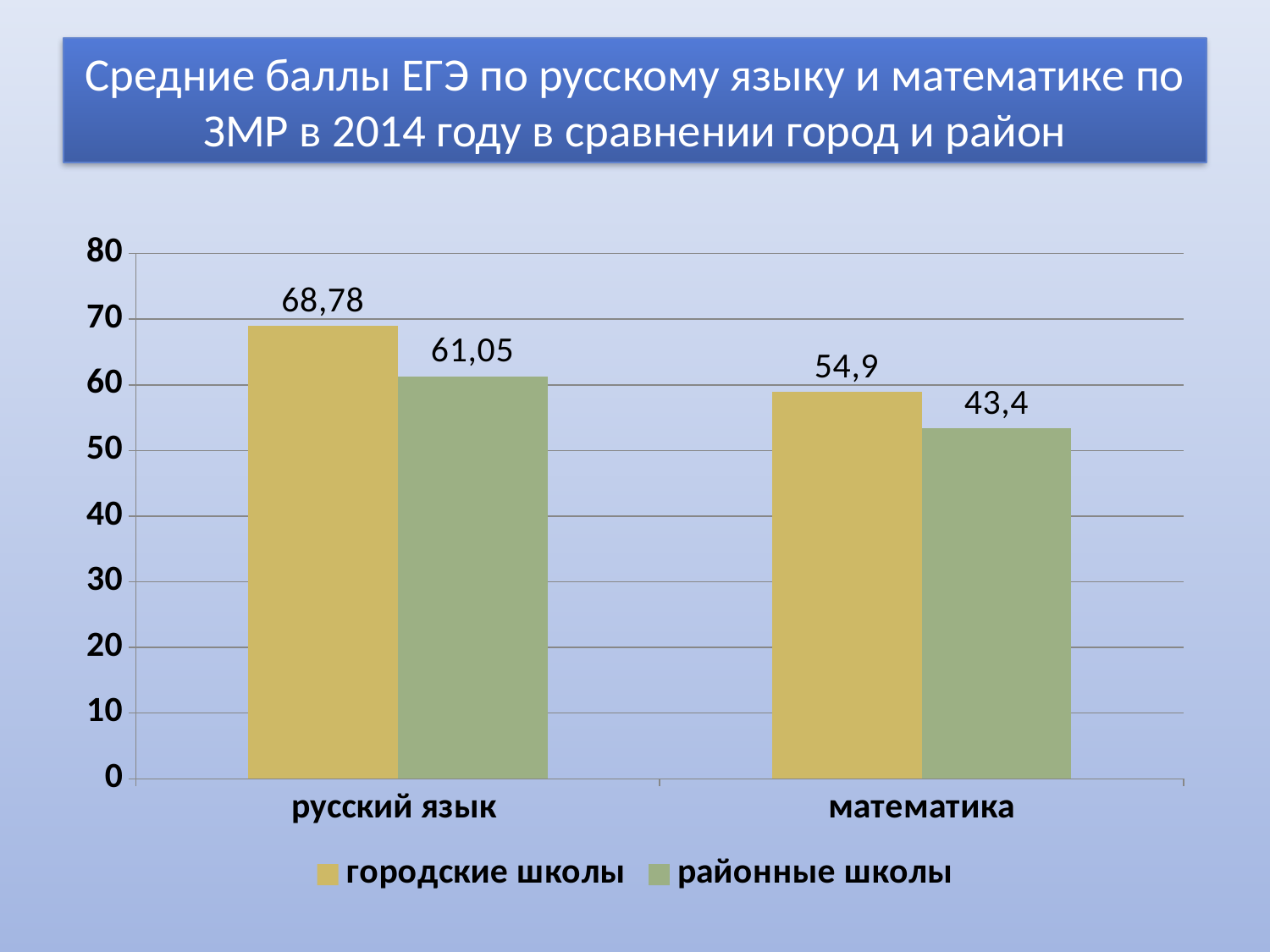
What kind of chart is shown on the slide? bar chart What is the value for районные школы in русский язык? 61,05 What is the difference between городские школы and районные школы in русский язык? 7,73 Which is larger: городские школы in математика or районные школы in русский язык? районные школы in русский язык How many categories are shown on the x axis? 2 What is the value for городские школы in русский язык? 68,78 Which bar has the highest value on the chart? городские школы, русский язык Which bar has the lowest value on the chart? районные школы, математика How many series does the legend list? 2 What is the difference between городские школы and районные школы in математика? 11,5 What is the value for районные школы in математика? 43,4 What is the value for городские школы in математика? 54,9